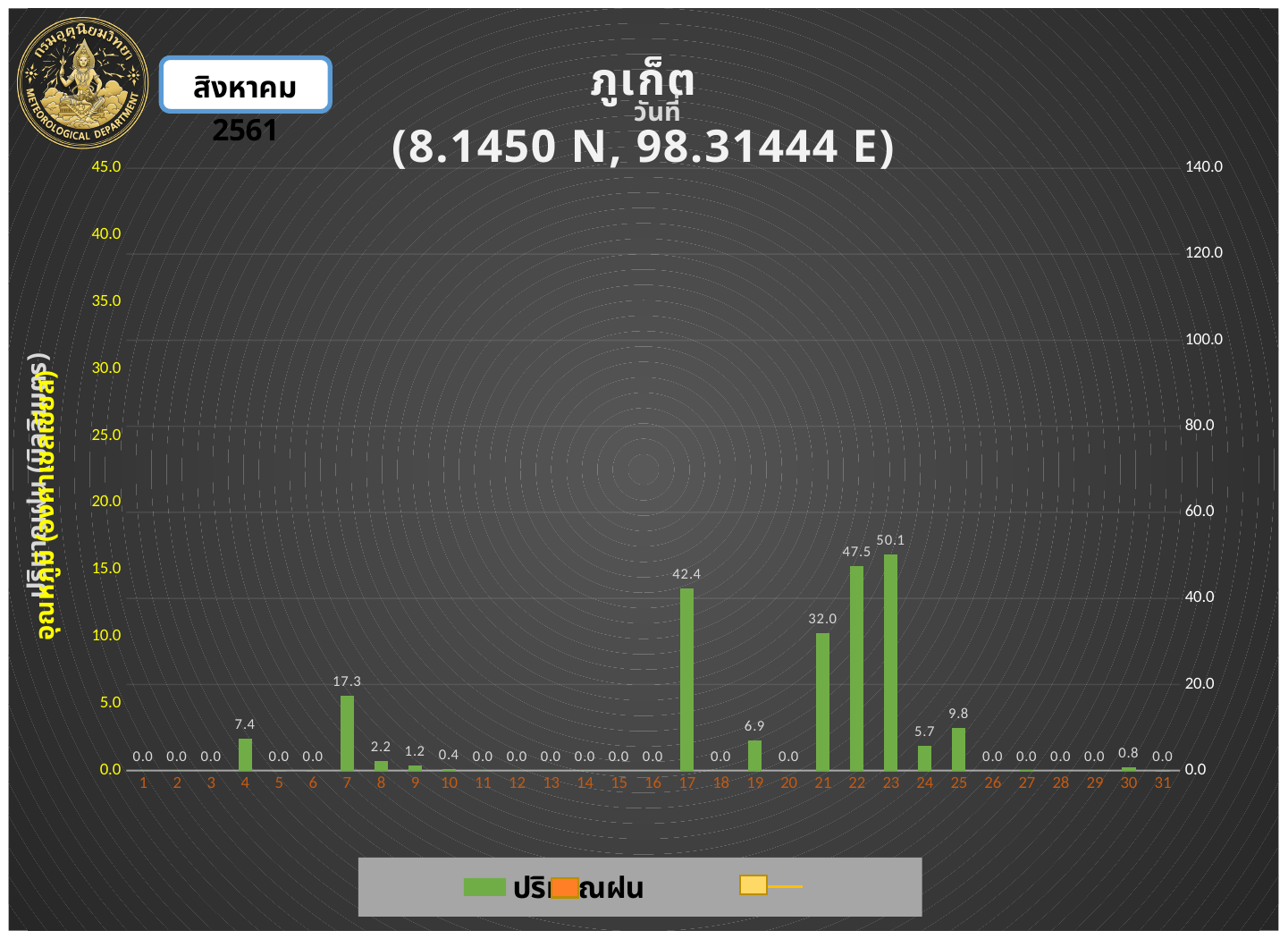
What kind of chart is shown on the slide? bar chart What is the difference between the rainfall values for day 23 and day 22? 2.6 How many days are shown on the x axis? 31 What is the difference between the rainfall values for day 17 and day 21? 10.4 What is the rainfall value shown for day 7? 17.3 What is the rainfall value shown for day 23? 50.1 Which is larger, the rainfall value for day 25 or for day 24? day 25 What are the coordinates shown in the chart title? 8.1450 N, 98.31444 E Which day has the highest rainfall value? 23 What is the rainfall value shown for day 17? 42.4 What is the rainfall value shown for day 21? 32.0 Which is larger, the rainfall value for day 4 or for day 19? day 4